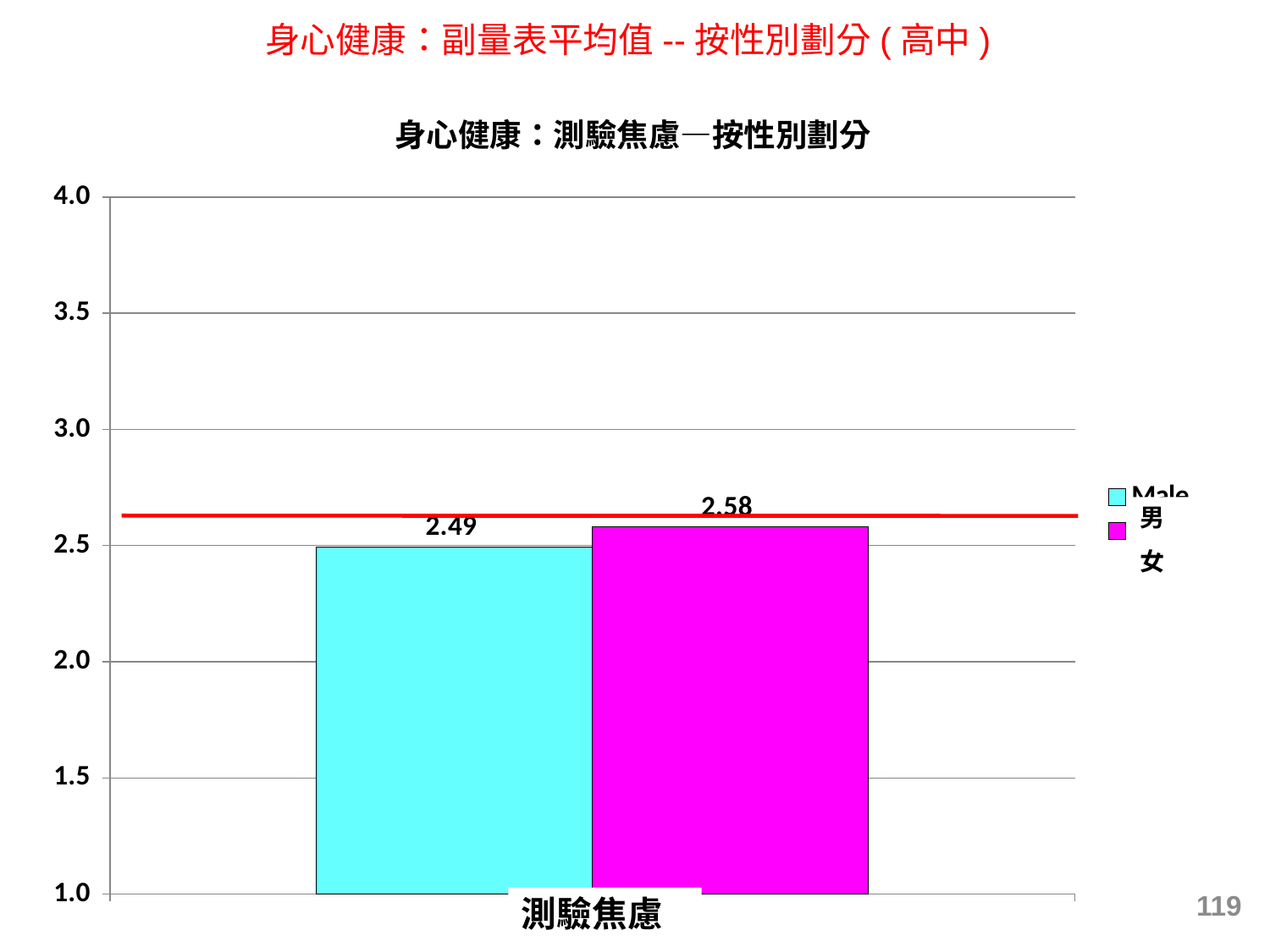
How many series does the legend list? 2 Which gender has the higher 測驗焦慮 value? 女 What is the value for 男 (male) in the 測驗焦慮 chart? 2.49 What colour is the bar for 女? magenta What is the difference between the 女 and 男 values for 測驗焦慮? 0.09 Is the value for 女 greater or less than 3.0? less Is the value for 男 greater or less than 2.0? greater Which gender has the lower 測驗焦慮 value? 男 Is the value for 男 larger or smaller than the value for 女? smaller How many categories are shown on the x axis of the chart? 1 What is the value for 女 (female) in the 測驗焦慮 chart? 2.58 What kind of chart is shown on the slide? bar chart